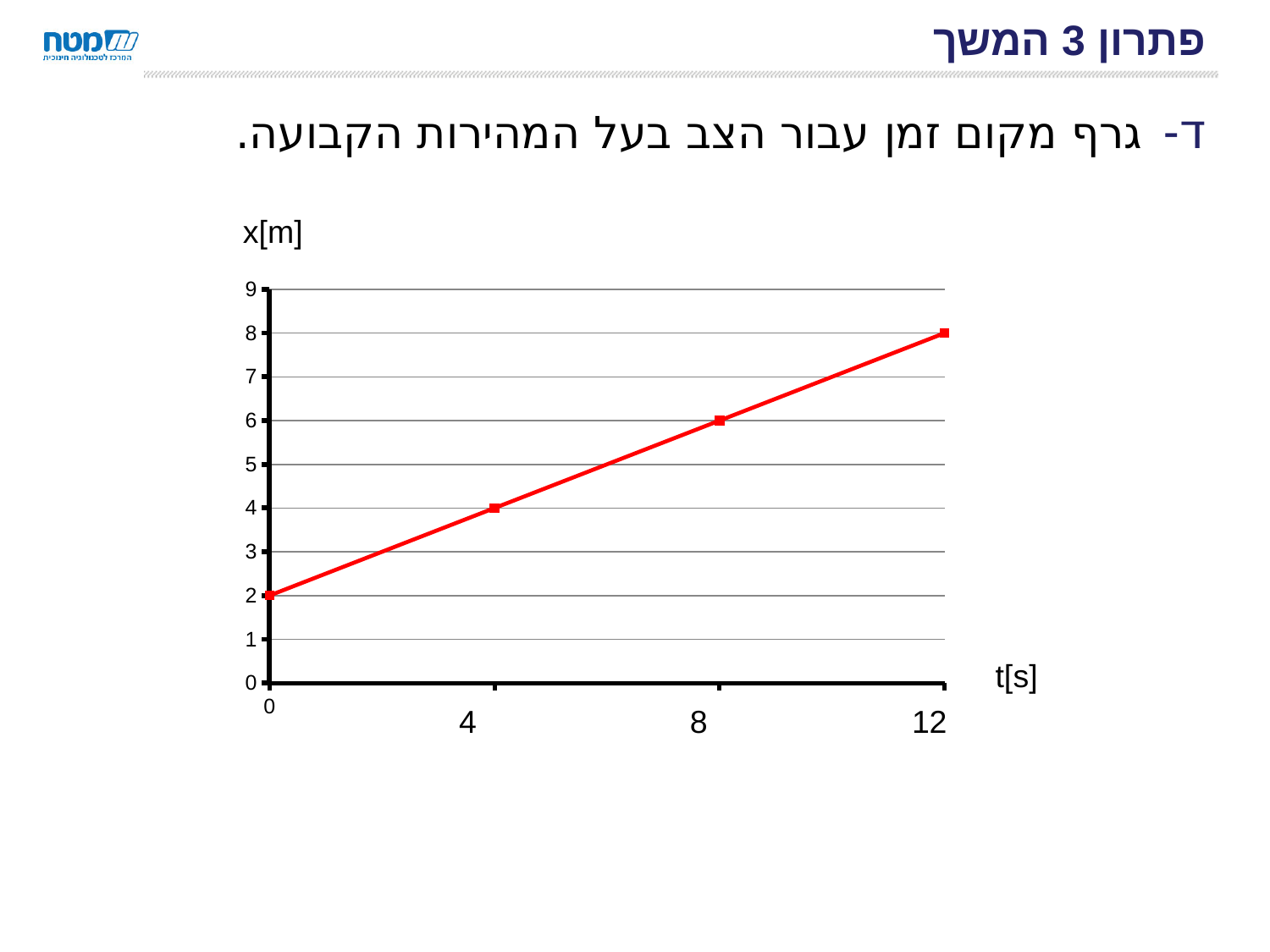
At which time t[s] is x[m] lowest? 0 What is the difference in x[m] between t = 12 s and t = 0 s? 6 What is the value of x[m] at t = 12 s? 8 What is the value of x[m] at t = 4 s? 4 What is the value of x[m] at t = 0 s? 2 What kind of chart is shown on the slide? line chart Does x[m] rise or fall as t[s] increases? rise What is the label of the vertical axis? x[m] What is the value of x[m] at t = 8 s? 6 How many data points are plotted on the line? 4 Which is larger, x[m] at t = 8 s or at t = 4 s? t = 8 s At which time t[s] is x[m] highest? 12